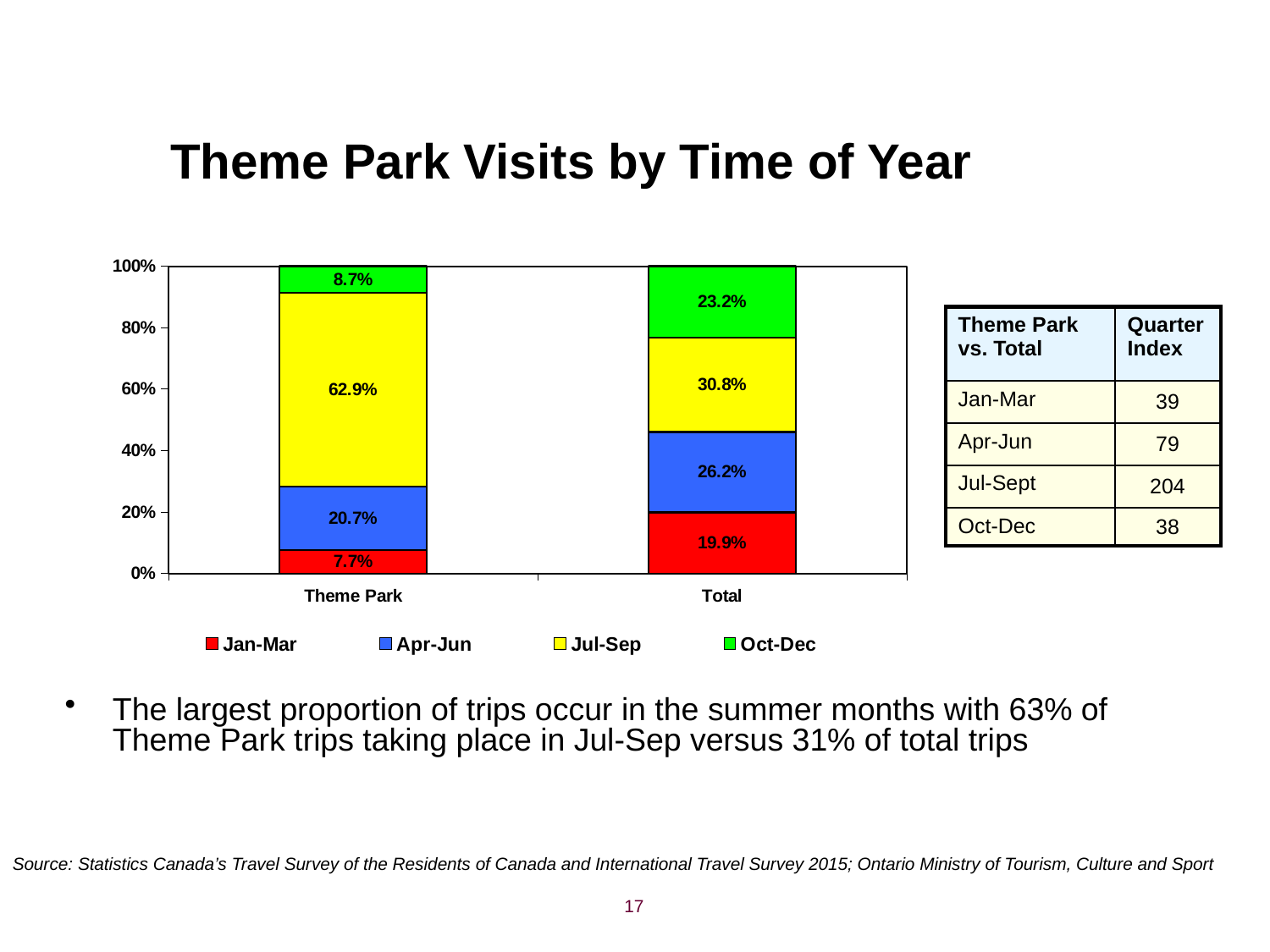
How many categories are shown on the x axis? 2 What is the difference between the Jul-Sep share for Theme Park and for Total? 32.1 percentage points What is the Apr-Jun value for the Total bar? 26.2% What is the Jan-Mar value for the Total bar? 19.9% How many series does the legend list? 4 What is the title of the slide containing the chart? Theme Park Visits by Time of Year What kind of chart is shown on the slide? Stacked bar chart What percentage of Theme Park visits occur in Jul-Sep? 62.9% Which is larger: the Oct-Dec share for Theme Park or for Total? Total Which quarter has the largest share of Theme Park visits? Jul-Sep Which quarter has the smallest share of Theme Park visits? Jan-Mar What is the Oct-Dec value for the Theme Park bar? 8.7%